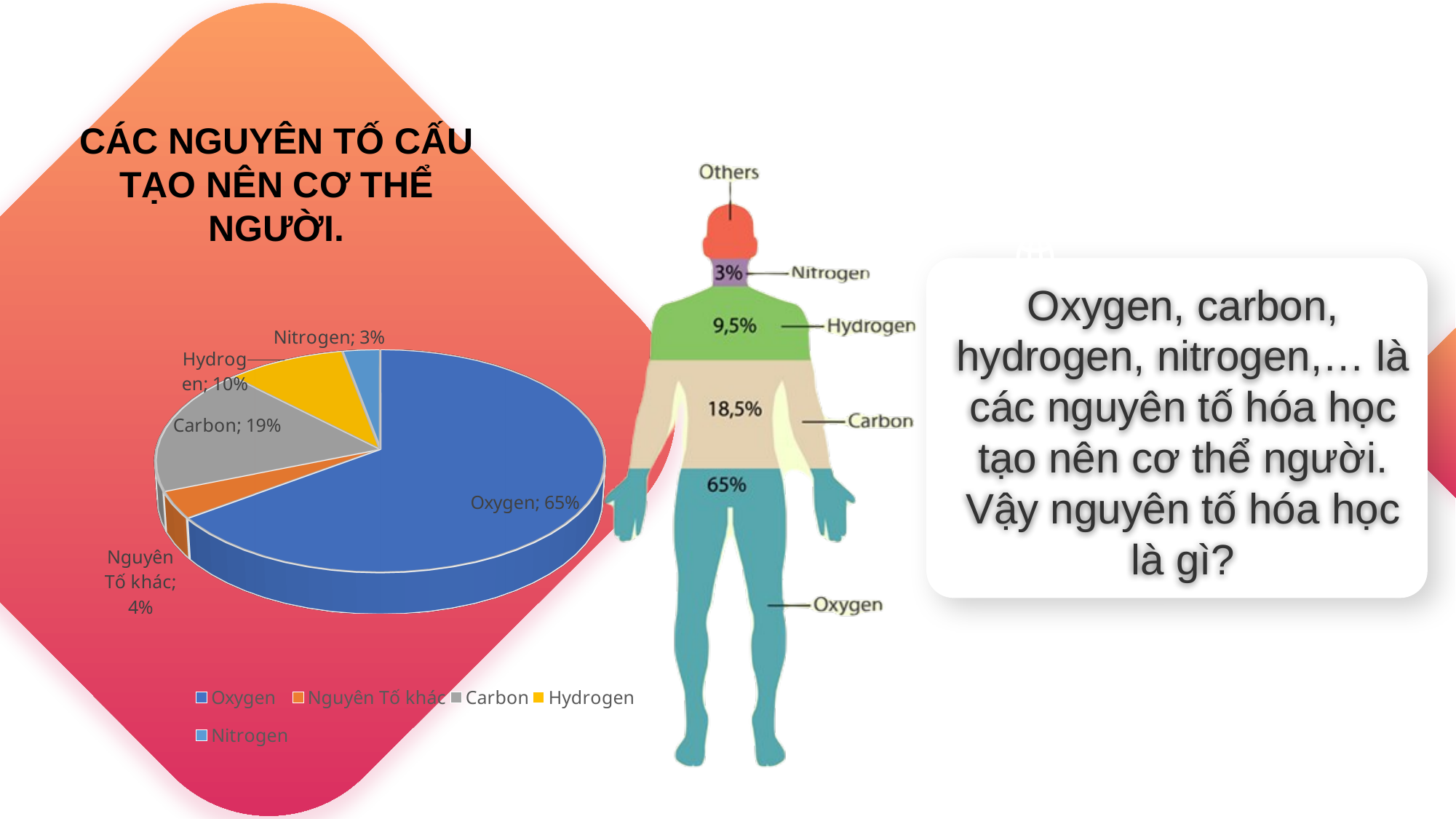
What kind of chart is shown on the slide? Pie chart Which is larger in the pie chart, Hydrogen or Nguyên Tố khác? Hydrogen Which category has the largest slice in the pie chart? Oxygen What percentage does the pie chart show for Hydrogen? 10% What is the difference between the Oxygen and Carbon percentages in the pie chart? 46% What is the title shown above the pie chart? CÁC NGUYÊN TỐ CẤU TẠO NÊN CƠ THỂ NGƯỜI. Which category has the smallest slice in the pie chart? Nitrogen What percentage does the pie chart show for Nitrogen? 3% What percentage does the pie chart show for Nguyên Tố khác? 4% What percentage does the pie chart show for Carbon? 19% How many categories does the pie chart have? 5 What percentage does the pie chart show for Oxygen? 65%